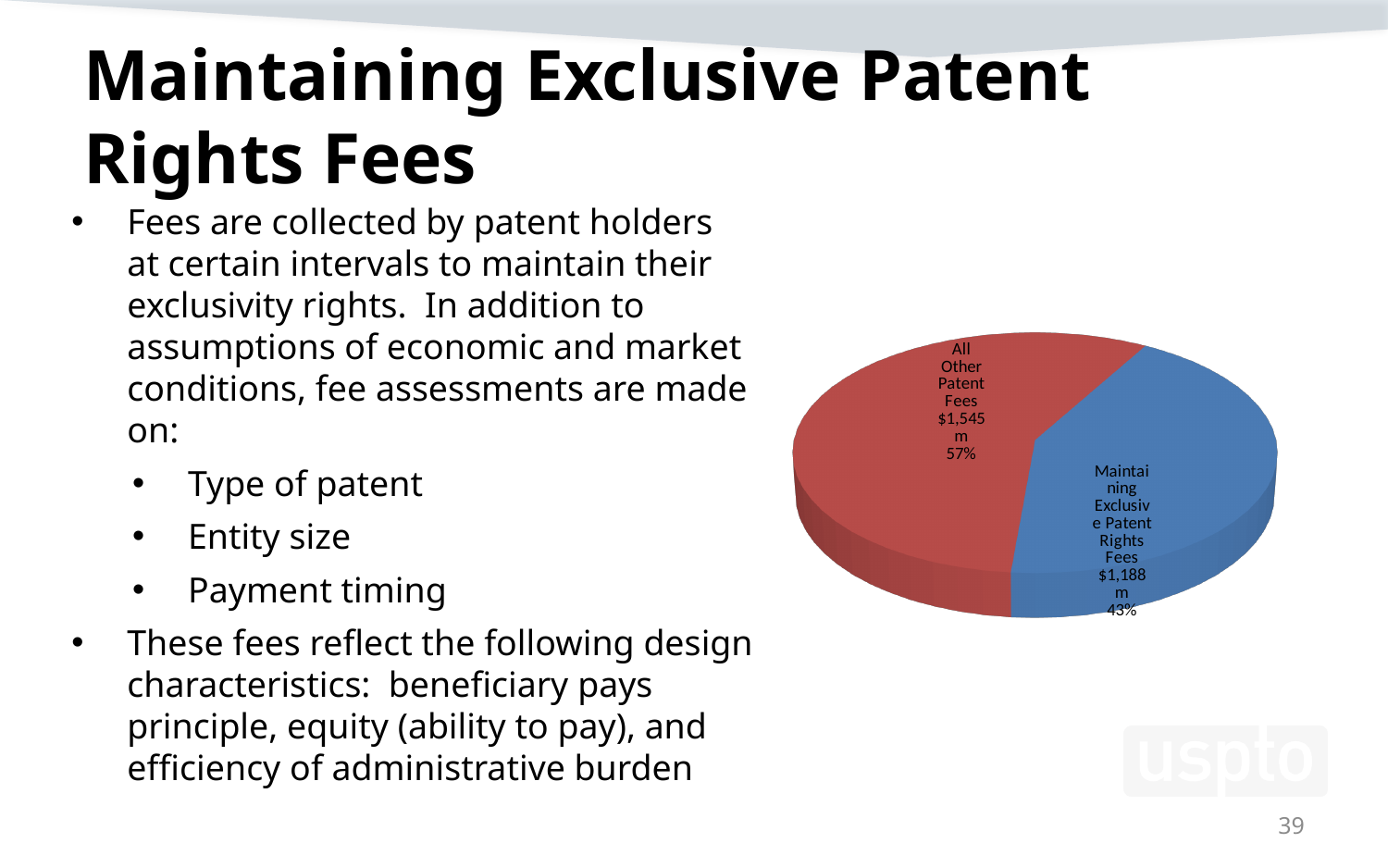
How many slices does the pie chart have? 2 What is the value shown for Maintaining Exclusive Patent Rights Fees in the pie chart? $1,188m What kind of chart is shown on the slide? pie chart What is the value shown for All Other Patent Fees in the pie chart? $1,545m Which slice of the pie chart is the largest? All Other Patent Fees What is the combined value of the two slices in the pie chart? $2,733m Which slice of the pie chart is the smallest? Maintaining Exclusive Patent Rights Fees What share of the pie does Maintaining Exclusive Patent Rights Fees represent? 43% What is the difference in dollar value between All Other Patent Fees and Maintaining Exclusive Patent Rights Fees in the pie chart? $357m What colour is the Maintaining Exclusive Patent Rights Fees slice in the pie chart? blue Which is larger in the pie chart, All Other Patent Fees or Maintaining Exclusive Patent Rights Fees? All Other Patent Fees What share of the pie does All Other Patent Fees represent? 57%